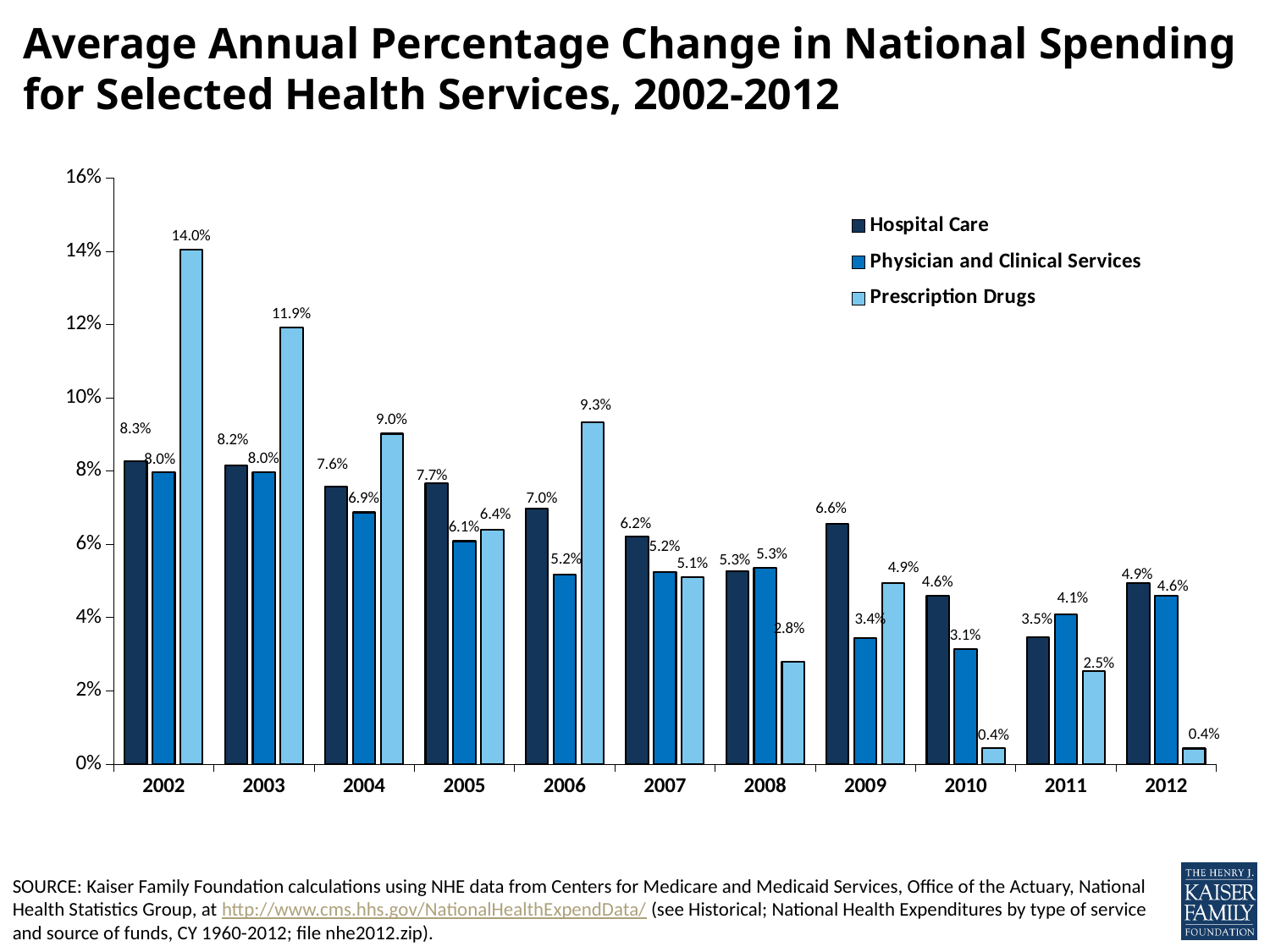
In which year was the Hospital Care value lowest? 2011 How many years are shown on the x axis? 11 What is the difference between Hospital Care and Physician and Clinical Services in 2009? 3.2% What was the value for Physician and Clinical Services in 2011? 4.1% What is the difference between the Prescription Drugs values in 2002 and 2003? 2.1% What was the average annual percentage change for Prescription Drugs in 2002? 14.0% How many series does the legend list? 3 In 2006, which was larger: Hospital Care or Prescription Drugs? Prescription Drugs In which year was the Prescription Drugs value highest? 2002 What kind of chart is shown on the slide? Bar chart What was the value for Hospital Care in 2009? 6.6% Does the Prescription Drugs value generally rise or fall from 2002 to 2012? Fall